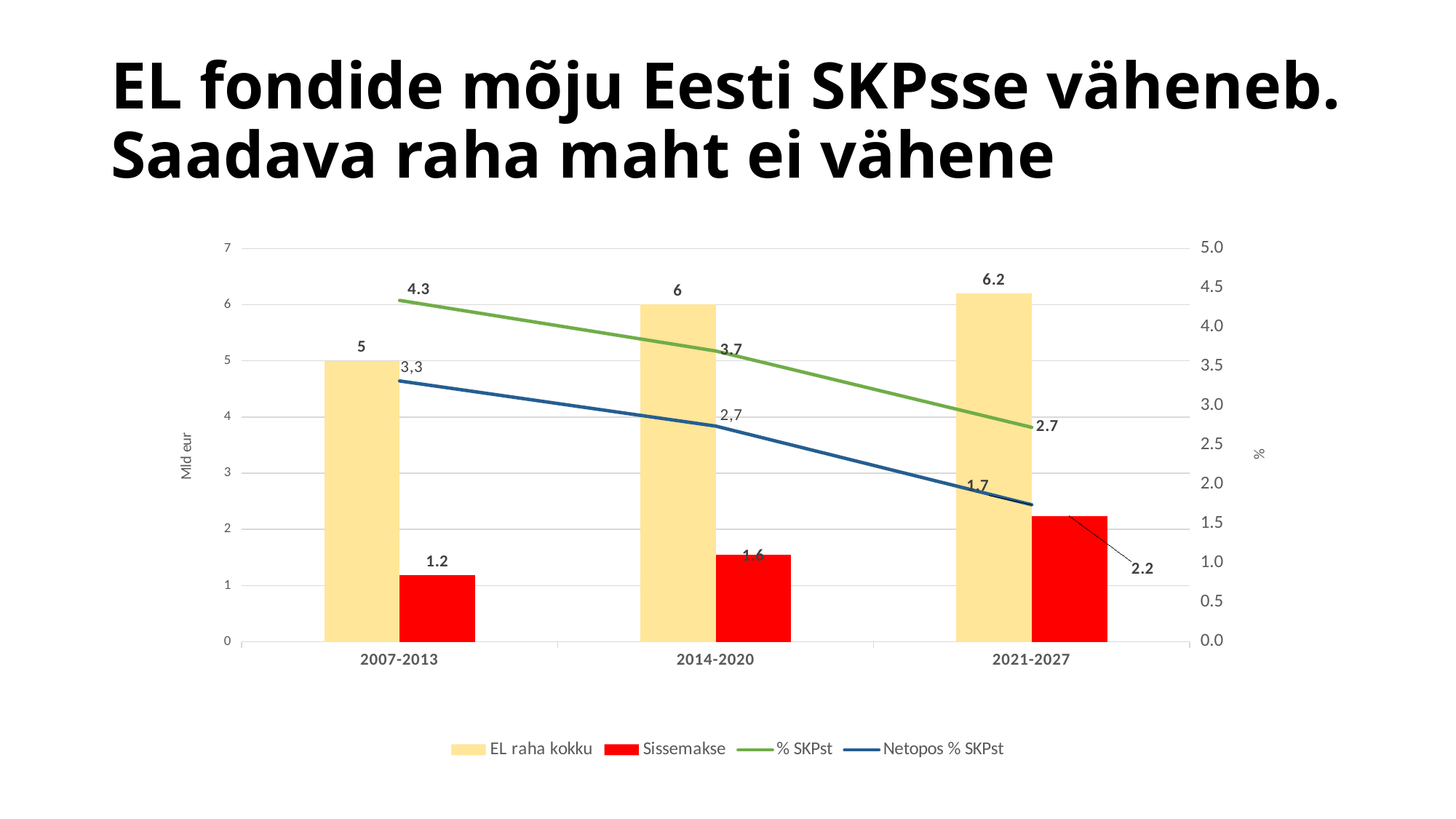
What is the % SKPst value for 2014-2020? 3.7 What is the value of EL raha kokku for 2021-2027? 6.2 What is the difference between the EL raha kokku values for 2014-2020 and 2007-2013? 1 What is the label of the left vertical axis? Mld eur Does the % SKPst line rise or fall from 2007-2013 to 2021-2027? fall Which period has the highest EL raha kokku value? 2021-2027 What is the Netopos % SKPst value for 2021-2027? 1,7 Which period has the lowest Sissemakse value? 2007-2013 Which is larger: the % SKPst value for 2007-2013 or for 2021-2027? 2007-2013 What is the value of Sissemakse for 2007-2013? 1.2 How many series does the legend list? 4 How many periods are shown on the x axis? 3